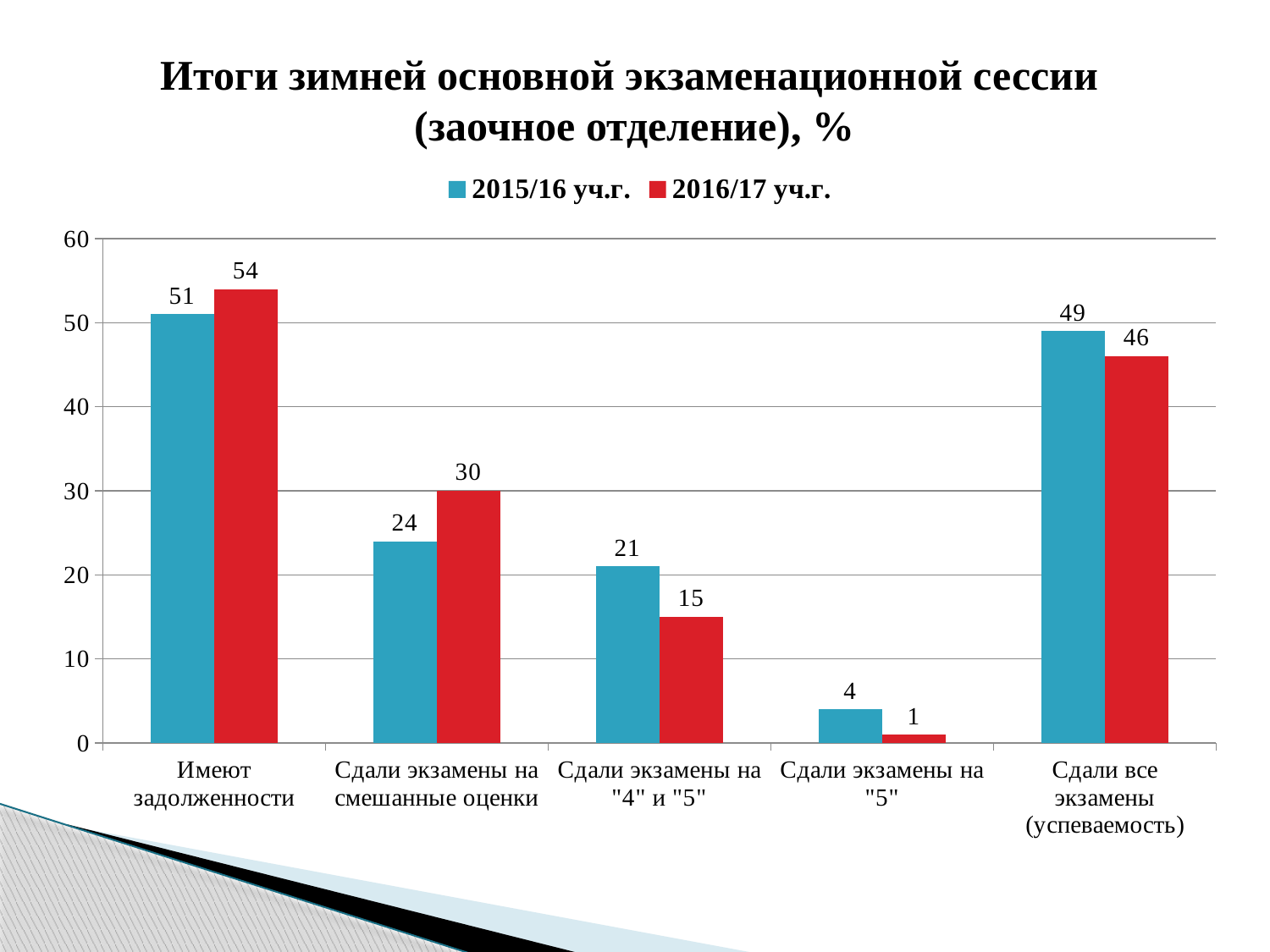
What is the value for "Имеют задолженности" in the 2016/17 уч.г. series? 54 What is the difference between the 2016/17 уч.г. and 2015/16 уч.г. values for "Сдали экзамены на смешанные оценки"? 6 How many series does the legend list? 2 Which category has the lowest value in the 2016/17 уч.г. series? Сдали экзамены на "5" Which category has the highest value in the 2015/16 уч.г. series? Имеют задолженности What is the value for "Сдали экзамены на "4" и "5"" in the 2015/16 уч.г. series? 21 What kind of chart is shown on the slide? bar chart Which series has the larger value for "Сдали экзамены на "4" и "5"": 2015/16 уч.г. or 2016/17 уч.г.? 2015/16 уч.г. What is the title of the chart? Итоги зимней основной экзаменационной сессии (заочное отделение), % Is the 2015/16 уч.г. value for "Сдали все экзамены (успеваемость)" greater or less than 40? greater How many categories are shown on the x axis? 5 What is the value for "Сдали все экзамены (успеваемость)" in the 2016/17 уч.г. series? 46